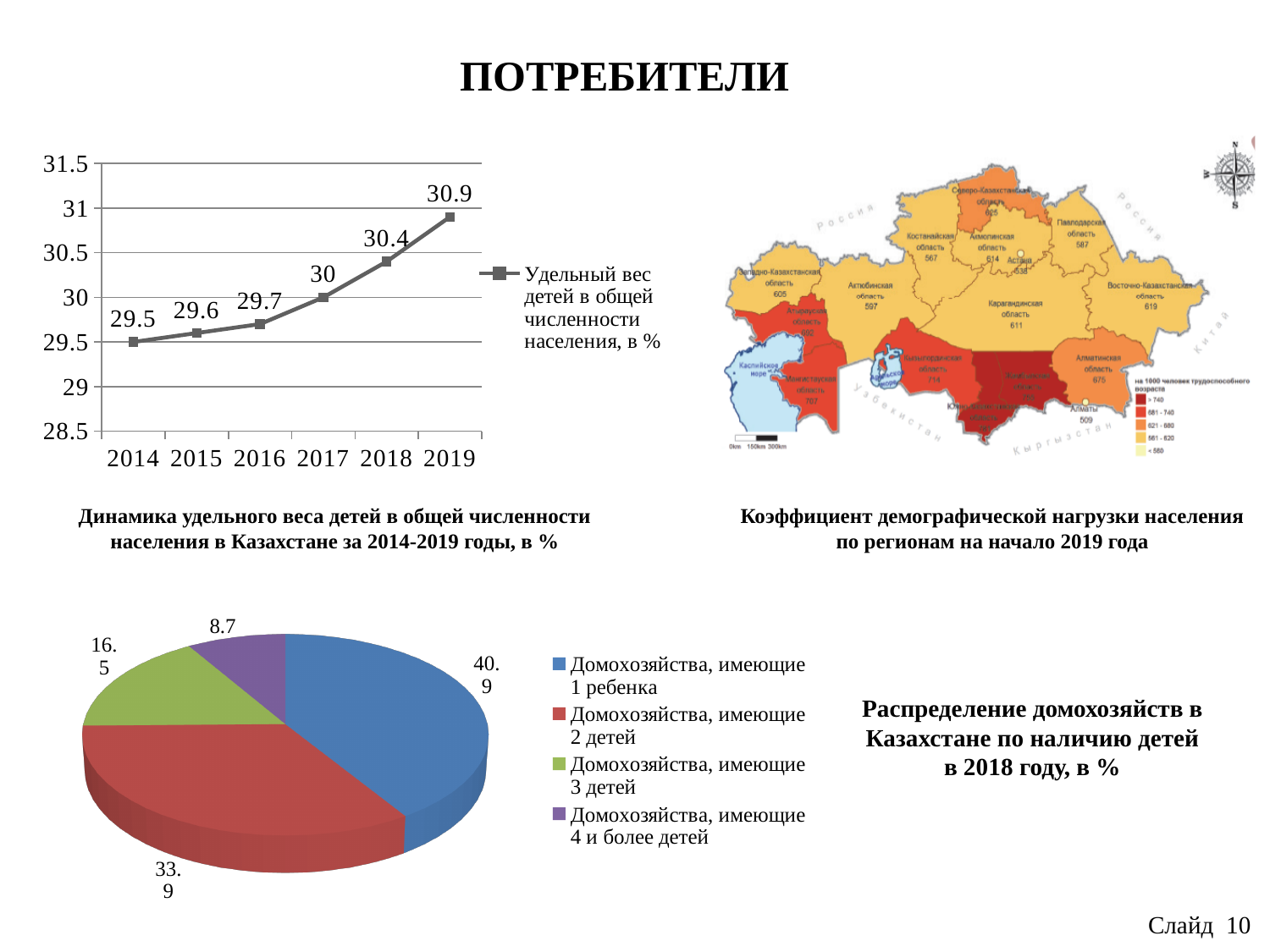
On the line chart (top left), how many years are plotted? 6 On the pie chart (bottom left), how many categories does the legend list? 4 On the line chart (top left), which year has the lowest value? 2014 On the pie chart (bottom left), which category has the largest slice? Домохозяйства, имеющие 1 ребенка On the line chart (top left), what is the difference between the values for 2019 and 2014? 1.4 On the line chart (top left), what is the value for 2014? 29.5 On the line chart (top left), what is the value for 2017? 30 On the line chart (top left), which year has the highest value? 2019 On the pie chart (bottom left), what is the value for households with 4 or more children (Домохозяйства, имеющие 4 и более детей)? 8.7 On the pie chart (bottom left), what is the value for households with 1 child (Домохозяйства, имеющие 1 ребенка)? 40.9 On the line chart (top left), do the values rise or fall from 2014 to 2019? rise On the line chart (top left), what is the value for 2019? 30.9